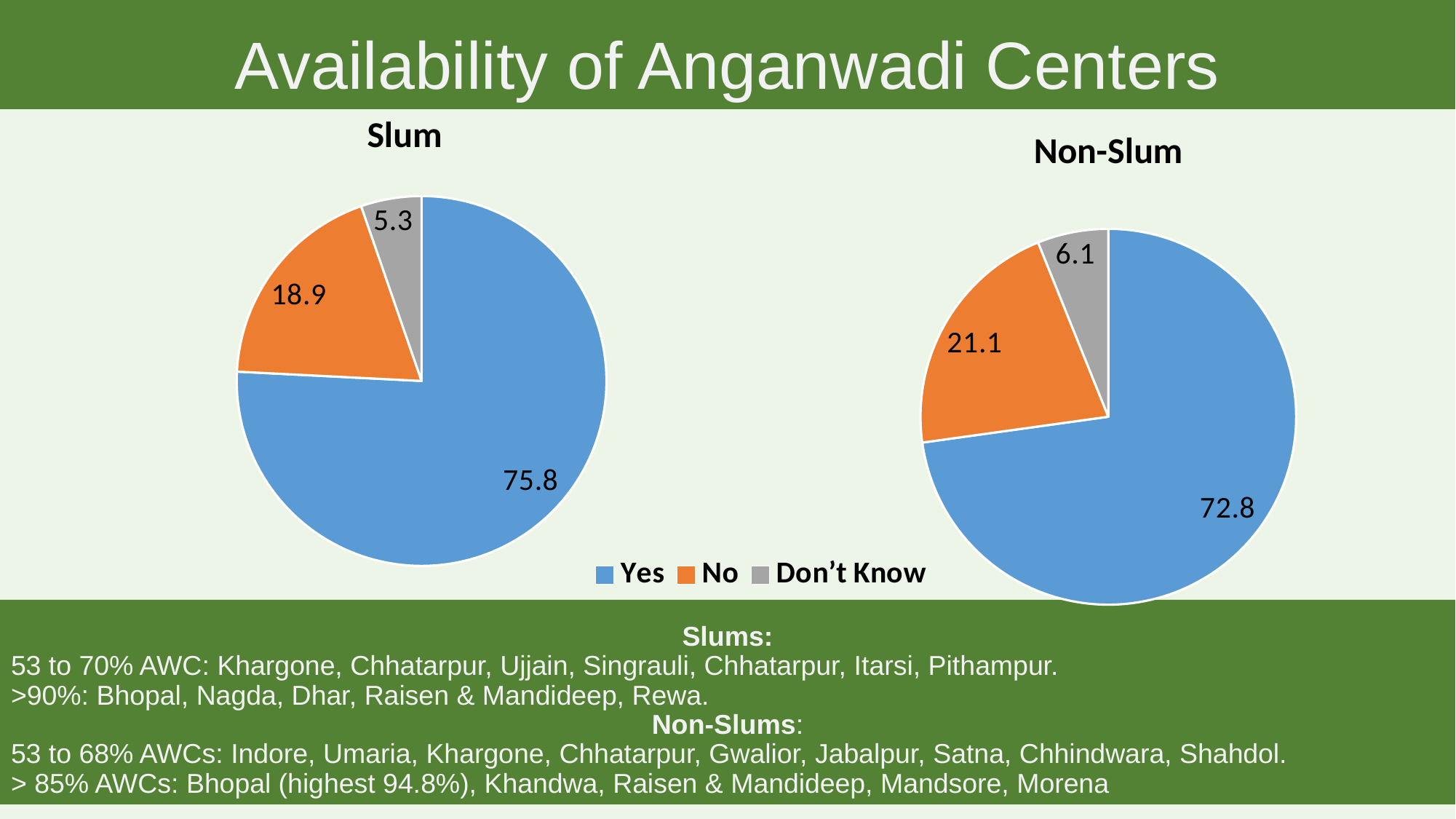
How many entries does the legend list? 3 What is the difference between the No values in the Non-Slum and Slum pie charts? 2.2 In the Slum pie chart, what is the value for Yes? 75.8 Is the Yes value larger in the Slum pie chart or the Non-Slum pie chart? Slum What type of chart is the Non-Slum chart? Pie chart In the Slum pie chart, what is the value for Don't Know? 5.3 How many slices does the Slum pie chart have? 3 In the Non-Slum pie chart, what is the value for Yes? 72.8 In the Slum pie chart, which category has the largest slice? Yes In the Non-Slum pie chart, what is the value for No? 21.1 Which colour represents No in the legend? Orange In the Non-Slum pie chart, which category has the smallest slice? Don't Know